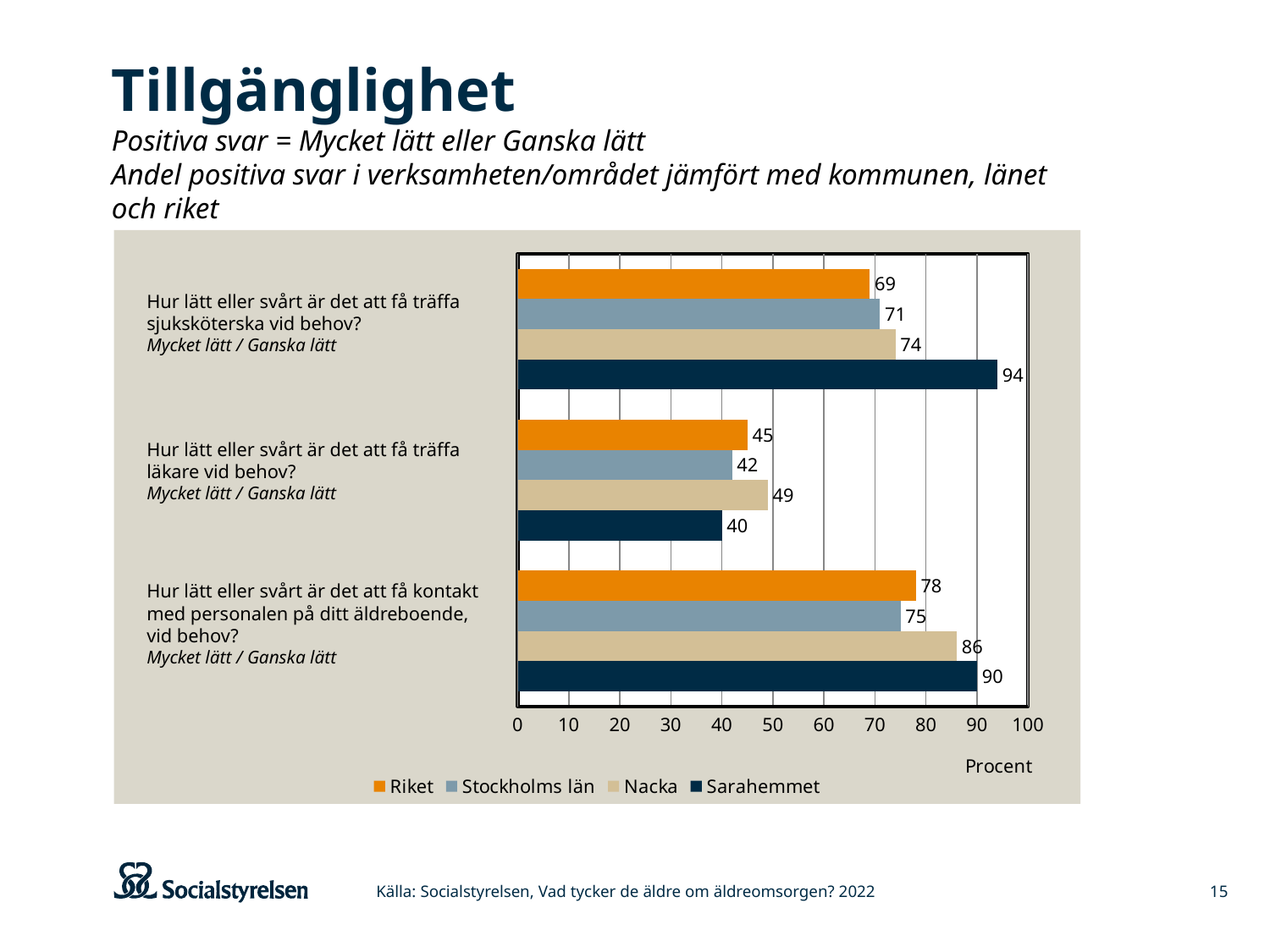
What is the value for Sarahemmet on the question about meeting a nurse when needed (träffa sjuksköterska vid behov)? 94 How many series does the legend list? 4 How many questions (categories) are shown on the chart? 3 Which is larger on the question about contact with staff: Nacka or Stockholms län? Nacka Which series has the highest value on the question about meeting a nurse when needed? Sarahemmet What kind of chart is shown on the slide? Bar chart What is the value for Stockholms län on the question about meeting a doctor when needed? 42 What unit is shown on the x axis of the chart? Procent What is the value for Nacka on the question about meeting a doctor when needed (träffa läkare vid behov)? 49 Which series has the lowest value on the question about meeting a doctor when needed? Sarahemmet What is the difference between Sarahemmet and Riket on the question about meeting a nurse when needed? 25 What is the value for Riket on the question about getting in contact with staff at the care home (kontakt med personalen)? 78